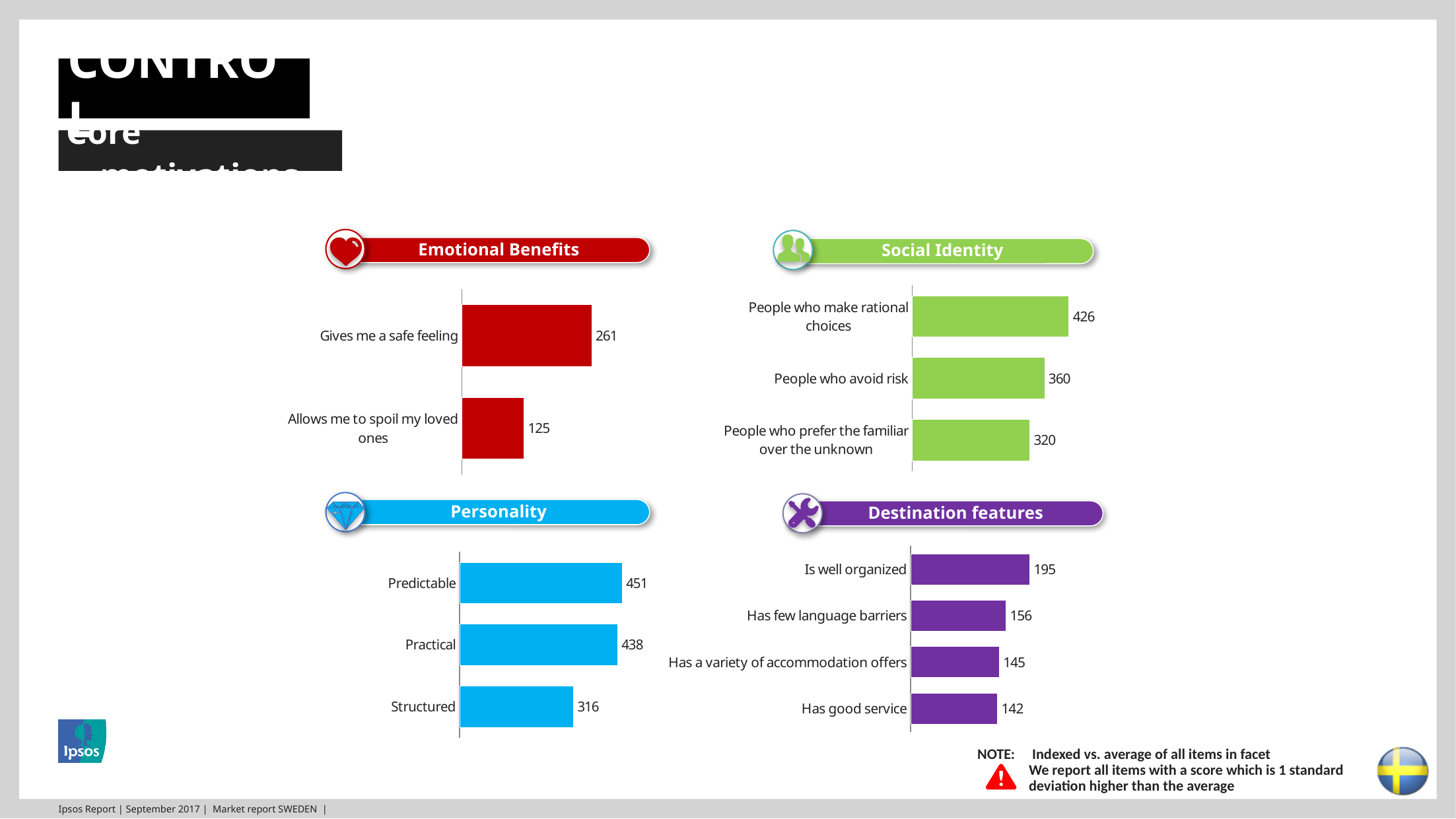
In the Personality chart, how many categories are plotted? 3 In the Social Identity chart, what is the difference between "People who make rational choices" and "People who prefer the familiar over the unknown"? 106 What kind of chart is the Emotional Benefits chart? Bar chart In the Destination features chart, which category has the highest value? Is well organized In the Personality chart, which category has the lowest value? Structured In the Social Identity chart, which category has the highest value? People who make rational choices In the Destination features chart, how many categories are plotted? 4 In the Emotional Benefits chart, what is the value for "Gives me a safe feeling"? 261 In the Emotional Benefits chart, what is the value for "Allows me to spoil my loved ones"? 125 In the Personality chart, what is the value for "Practical"? 438 In the Destination features chart, which is larger: "Has few language barriers" or "Has good service"? Has few language barriers In the Social Identity chart, what is the value for "People who avoid risk"? 360